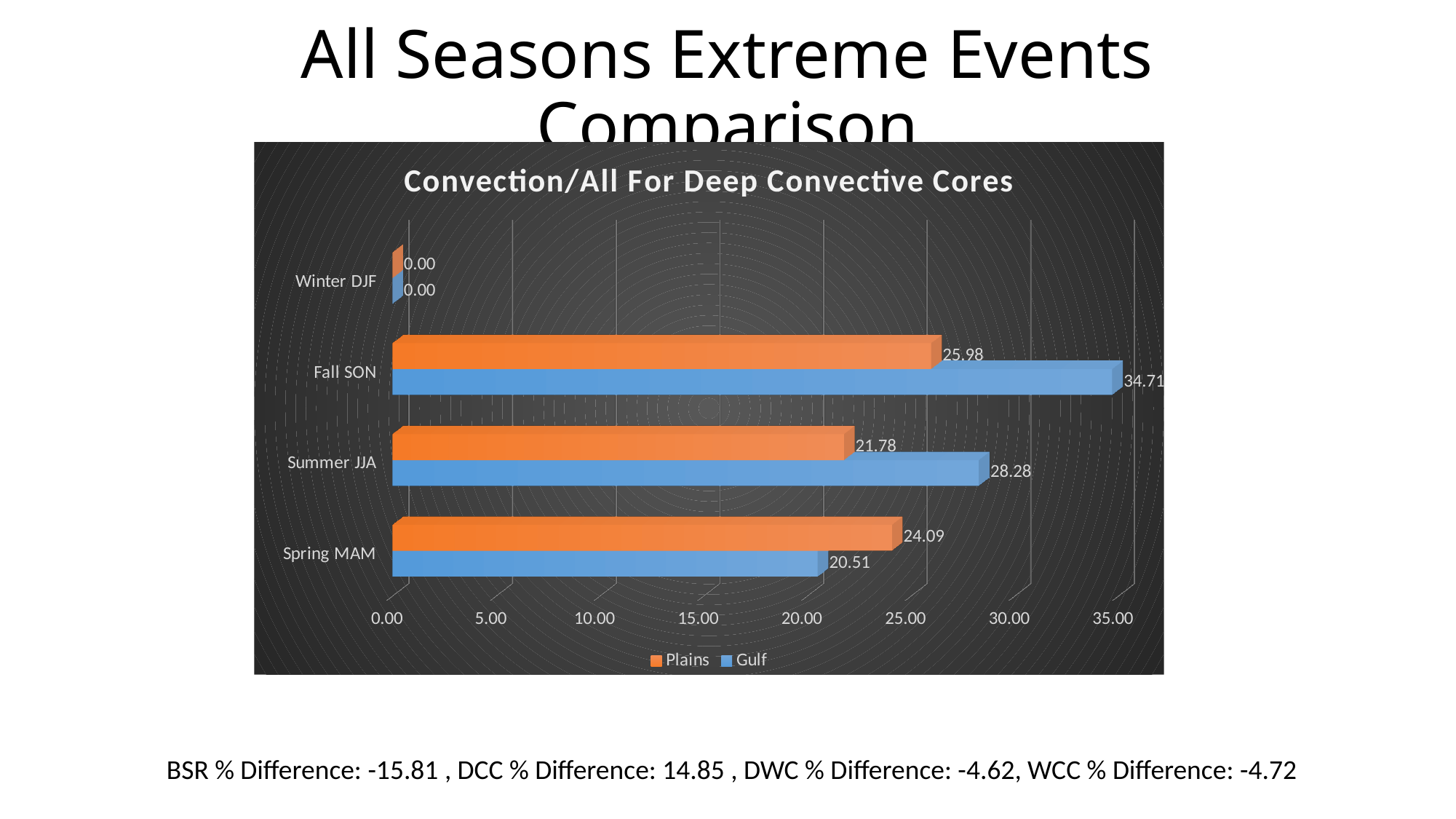
What is the Plains value for Summer JJA? 21.78 For Spring MAM, which series has the larger value, Plains or Gulf? Plains Which season has the lowest Plains value? Winter DJF What is the difference between the Gulf and Plains values for Fall SON? 8.73 What is the Gulf value for Fall SON? 34.71 What is the Plains value for Winter DJF? 0.00 Which season has the highest Gulf value? Fall SON How many series does the legend list? 2 What is the Gulf value for Spring MAM? 20.51 Is the Gulf value for Summer JJA greater or less than 25.00? greater What type of chart is shown on the slide? Bar chart How many seasons are shown on the chart? 4